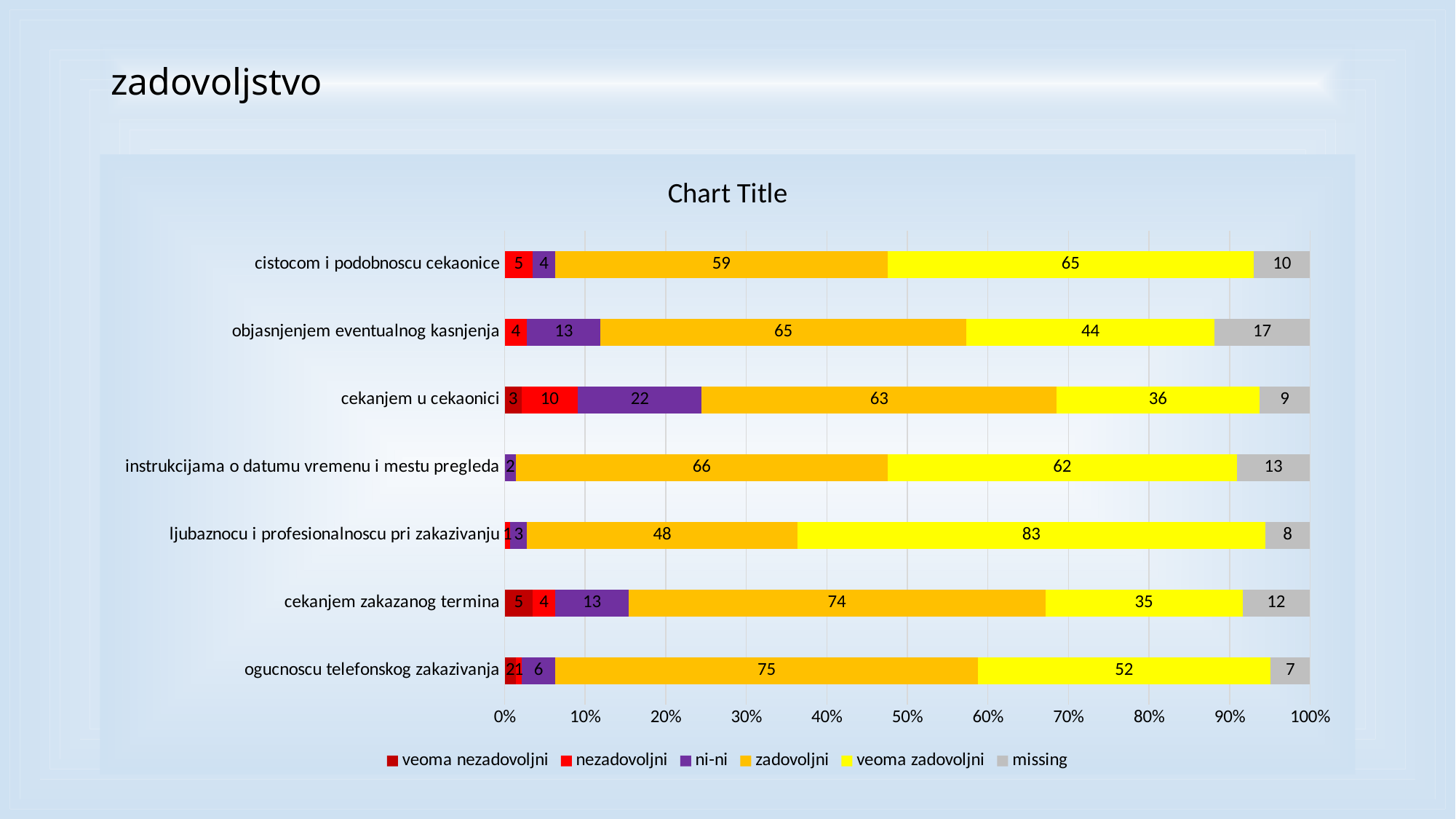
What is the value of the "zadovoljni" segment for "cekanjem zakazanog termina"? 74 Which category has the lowest "missing" value? ogucnoscu telefonskog zakazivanja What is the total of all segments in the bar for "cekanjem u cekaonici"? 143 What is the value of the "missing" segment for "objasnjenjem eventualnog kasnjenja"? 17 Which is larger: the "zadovoljni" value for "ogucnoscu telefonskog zakazivanja" or for "instrukcijama o datumu vremenu i mestu pregleda"? ogucnoscu telefonskog zakazivanja What is the difference between the "veoma zadovoljni" values for "cistocom i podobnoscu cekaonice" and "cekanjem u cekaonici"? 29 What is the value of the "ni-ni" segment for "cekanjem u cekaonici"? 22 What is the title of the chart? Chart Title Which category has the highest "veoma zadovoljni" value? ljubaznocu i profesionalnoscu pri zakazivanju What kind of chart is shown on the slide? Stacked bar chart How many categories are shown on the chart? 7 How many series does the legend list? 6